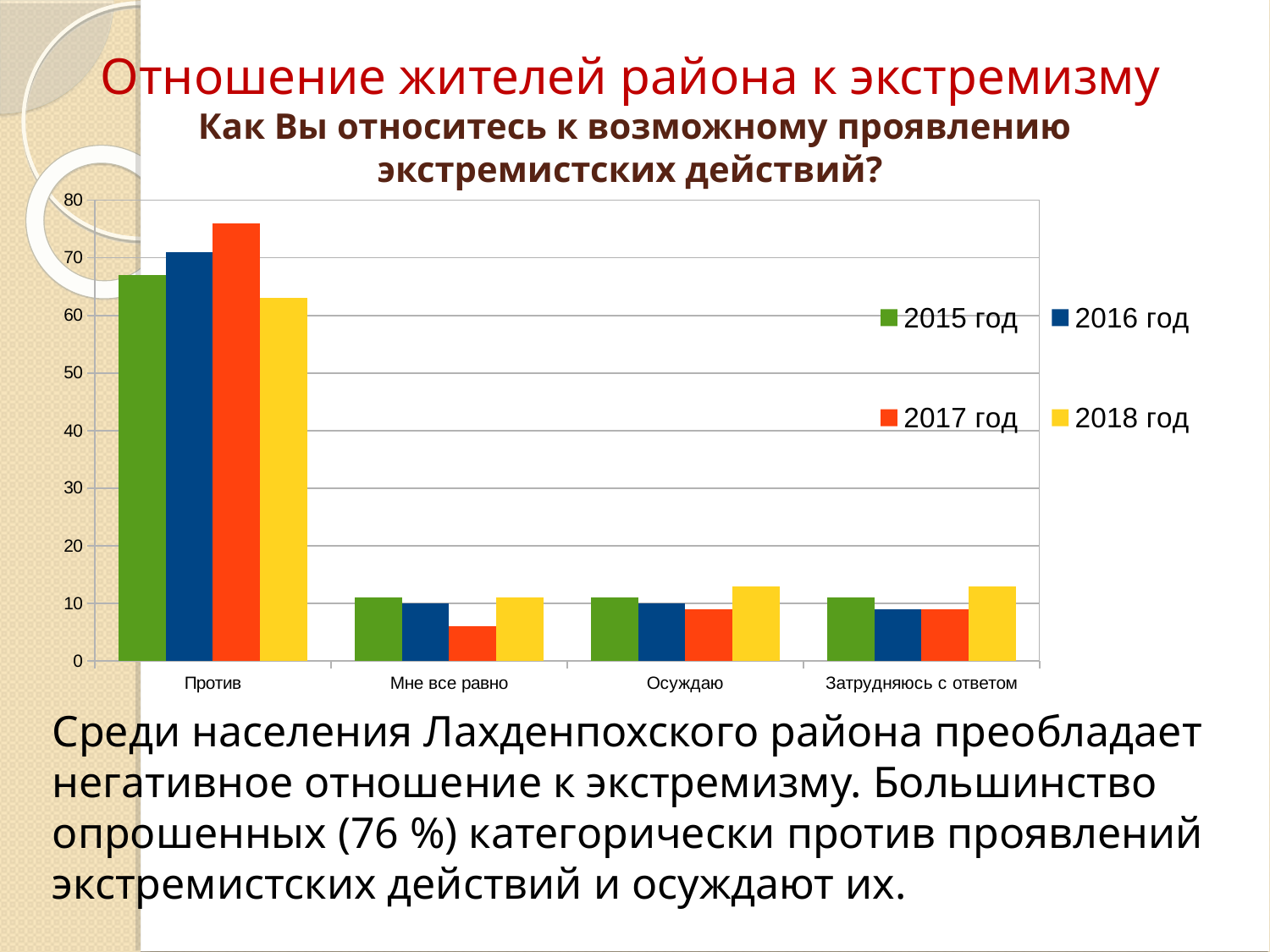
What kind of chart is shown on the slide? bar chart Is the value for 2017 год in the category "Против" greater or less than 70? greater Which category has the highest bars in the chart? Против How many categories are shown on the x axis of the chart? 4 Is the value for 2018 год in the category "Против" greater or less than 70? less In the category "Против", which year has the shortest bar? 2018 год Is the value for 2017 год in the category "Мне все равно" greater or less than 10? less How many series does the chart legend list? 4 In the category "Мне все равно", which year has the lowest bar? 2017 год Which colour represents the series "2018 год" in the chart? yellow In the category "Против", which is larger: the value for 2017 год or for 2018 год? 2017 год In the category "Против", which year has the tallest bar? 2017 год